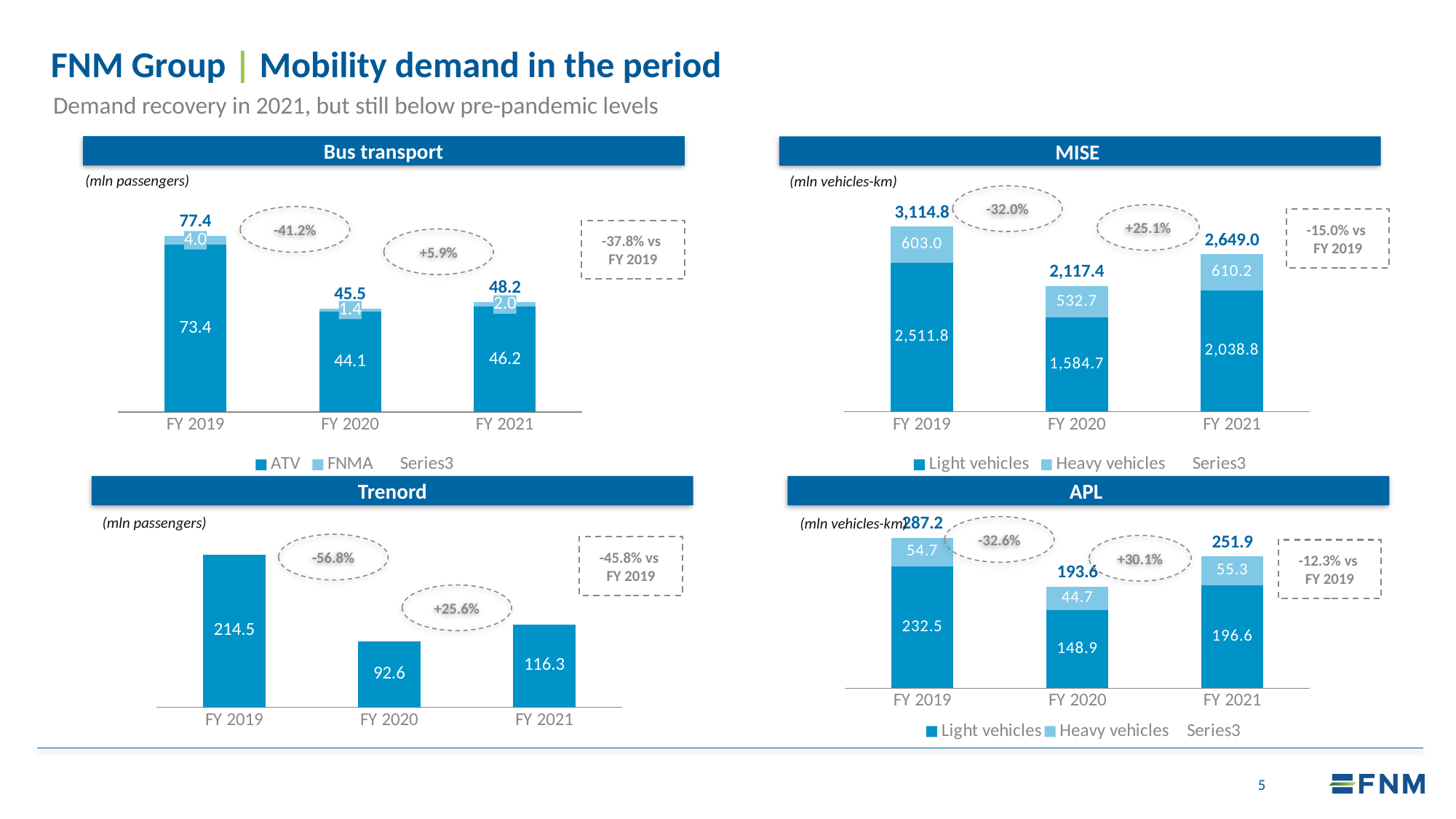
In the APL chart, what is the total of the stacked bar for FY 2020? 193.6 What kind of chart is the Trenord chart? Bar chart In the Trenord chart, what is the value for FY 2020? 92.6 In the MISE chart, which year has the lowest Light vehicles value? FY 2020 In the Trenord chart, how many years are shown on the x axis? 3 In the MISE chart, what is the difference between the Light vehicles values for FY 2019 and FY 2021? 473.0 In the Bus transport chart, what is the ATV value for FY 2019? 73.4 In the APL chart, is the Light vehicles value larger for FY 2019 or FY 2021? FY 2019 In the MISE chart, what is the Heavy vehicles value for FY 2021? 610.2 In the Bus transport chart, what is the total of the stacked bar for FY 2021? 48.2 In the Trenord chart, which year has the highest value? FY 2019 In the Bus transport chart, what is the FNMA value for FY 2020? 1.4